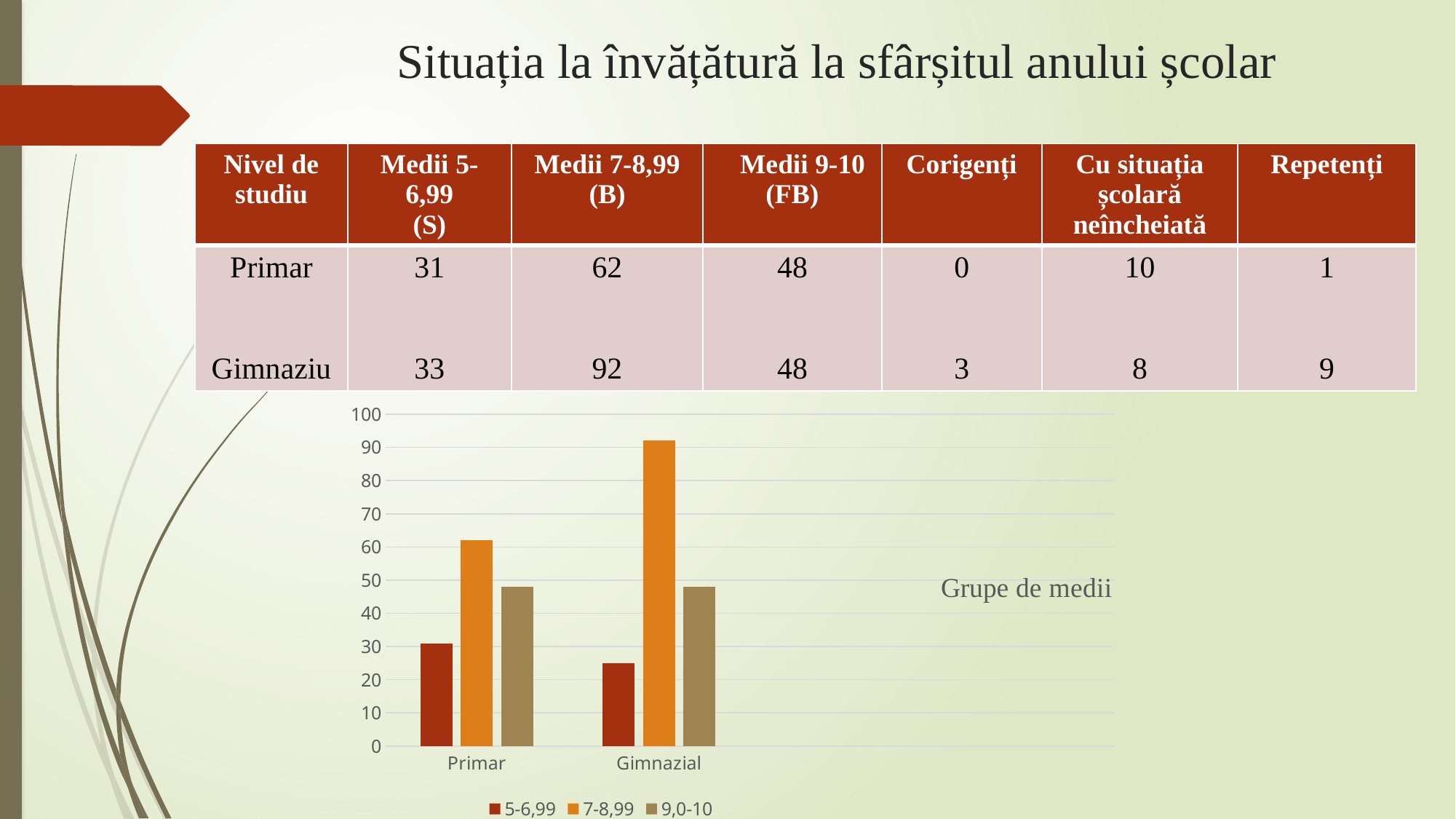
Which is larger: the 7-8,99 bar for Primar or the 7-8,99 bar for Gimnazial? Gimnazial Is the value for 9,0-10 in the Primar group greater or less than 40? greater Which is larger: the 5-6,99 bar for Primar or the 5-6,99 bar for Gimnazial? Primar Is the value for 7-8,99 in the Gimnazial group greater or less than 90? greater Which series has the shortest bar in the Primar group? 5-6,99 Which series has the tallest bar in the Gimnazial group? 7-8,99 Is the value for 7-8,99 in the Primar group greater or less than 70? less What kind of chart is shown on the slide? bar chart How many categories are shown on the x axis of the chart? 2 What is the text label shown to the right of the chart? Grupe de medii How many series does the chart legend list? 3